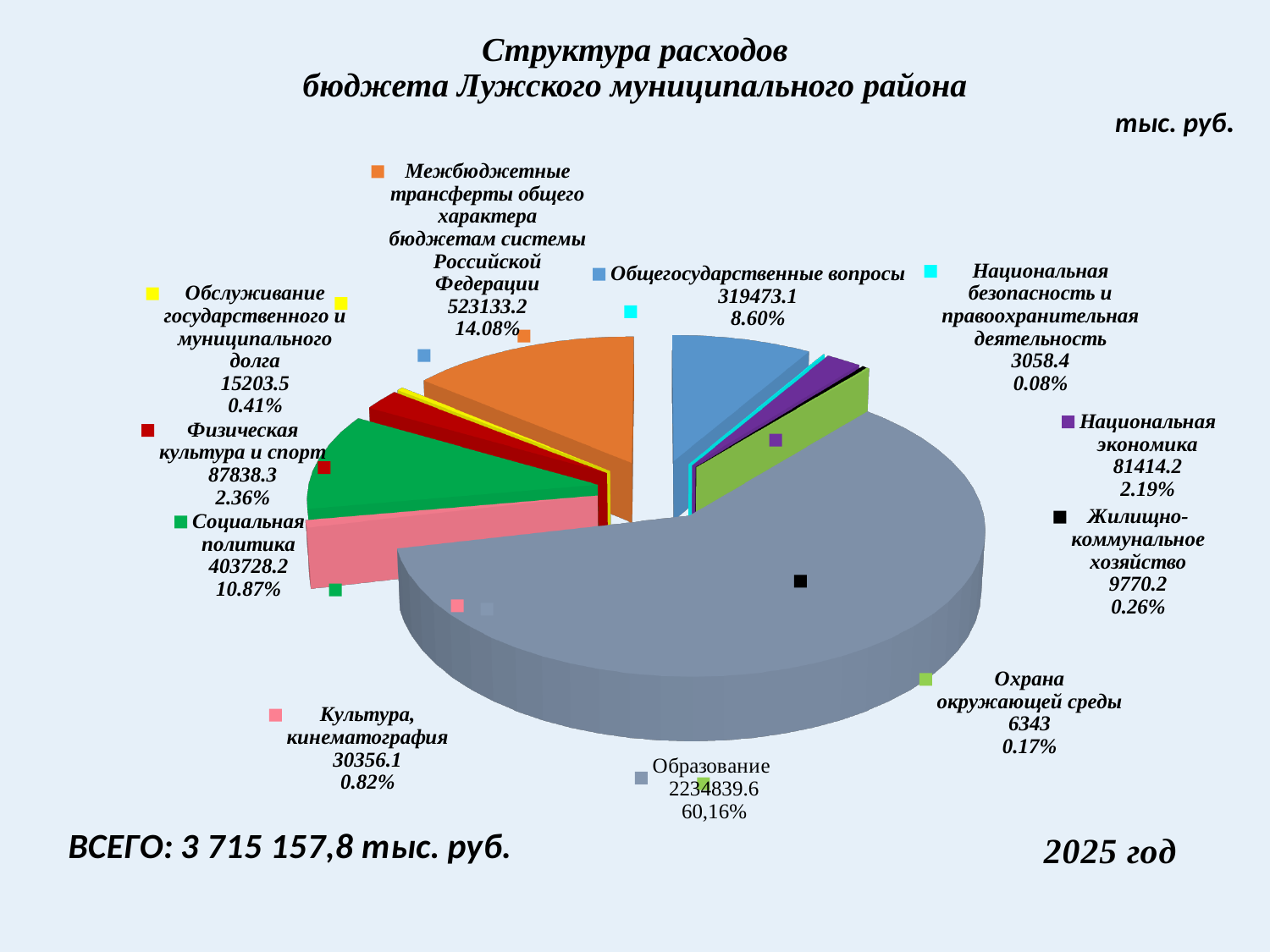
What is the value for Социальная политика? 403728.2 What percentage is shown for Межбюджетные трансферты общего характера бюджетам системы Российской Федерации? 14.08% What is the value for Охрана окружающей среды? 6343 What share of the pie does Образование take? 60,16% What kind of chart is shown on the slide? pie chart What is the value for Образование? 2234839.6 What is the difference between the values for Социальная политика and Общегосударственные вопросы? 84255.1 Which is larger: Физическая культура и спорт or Национальная экономика? Физическая культура и спорт How many categories are shown in the pie chart? 11 What total (ВСЕГО) is stated on the slide? 3 715 157,8 тыс. руб. Which category has the largest slice of the pie? Образование Which category has the smallest value? Национальная безопасность и правоохранительная деятельность